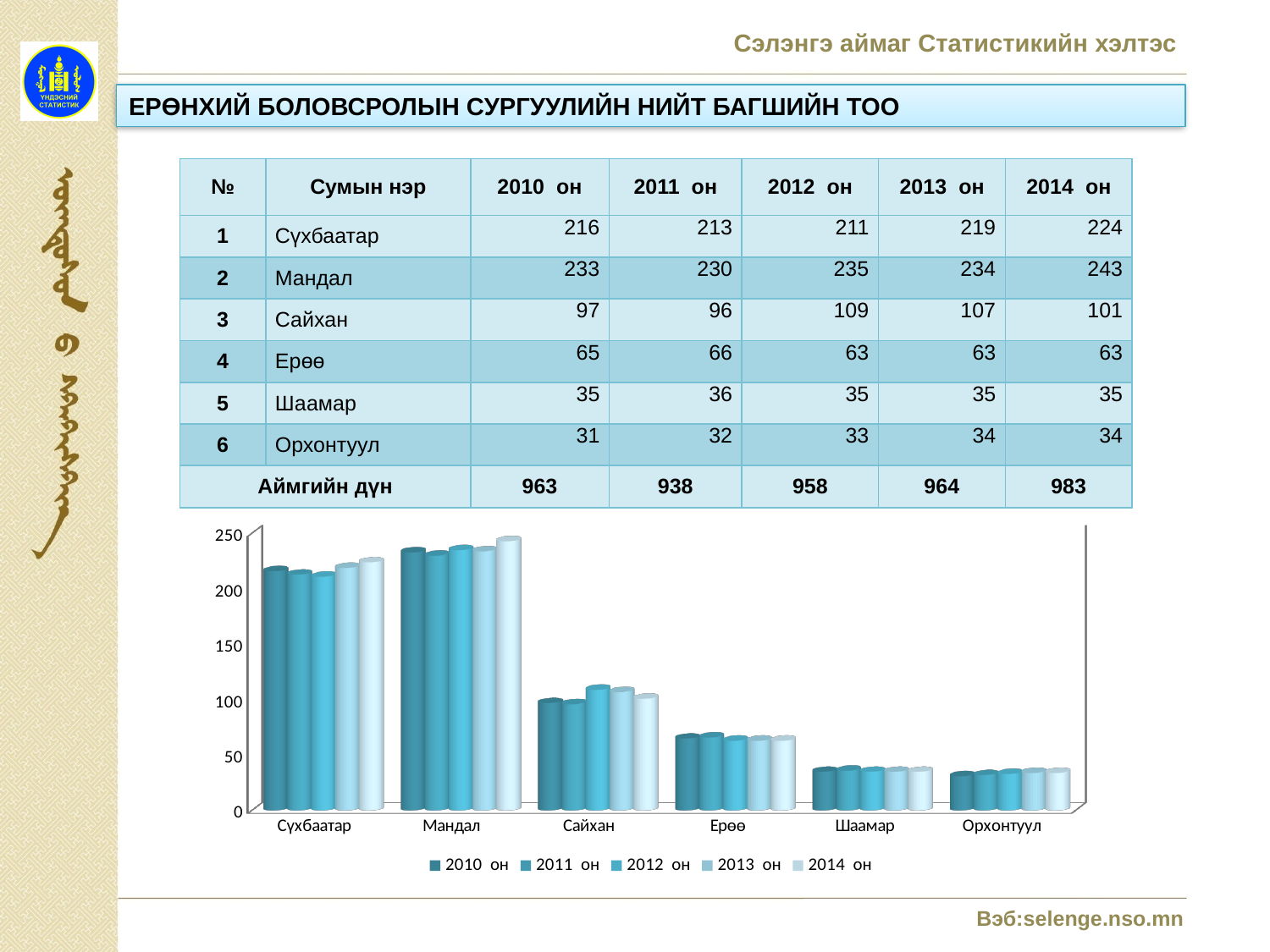
What is the value for Сайхан in the 2012 он series? 109 Which category has the highest values in the chart? Мандал Is the value for Шаамар in 2014 он greater or less than 50? less How many series does the chart legend list? 5 Is the value for Ерөө in 2010 он greater or less than 50? greater What is the value for Мандал in the 2014 он series? 243 How many categories (sums) are shown on the x axis of the chart? 6 What type of chart is shown on the slide? bar chart Which category has the lowest values in the chart? Орхонтуул Do the values for Орхонтуул rise or fall from 2010 он to 2014 он? rise What is the difference between the 2014 он and 2010 он values for Сүхбаатар? 8 Which is larger, the 2013 он value for Сайхан or the 2013 он value for Ерөө? Сайхан